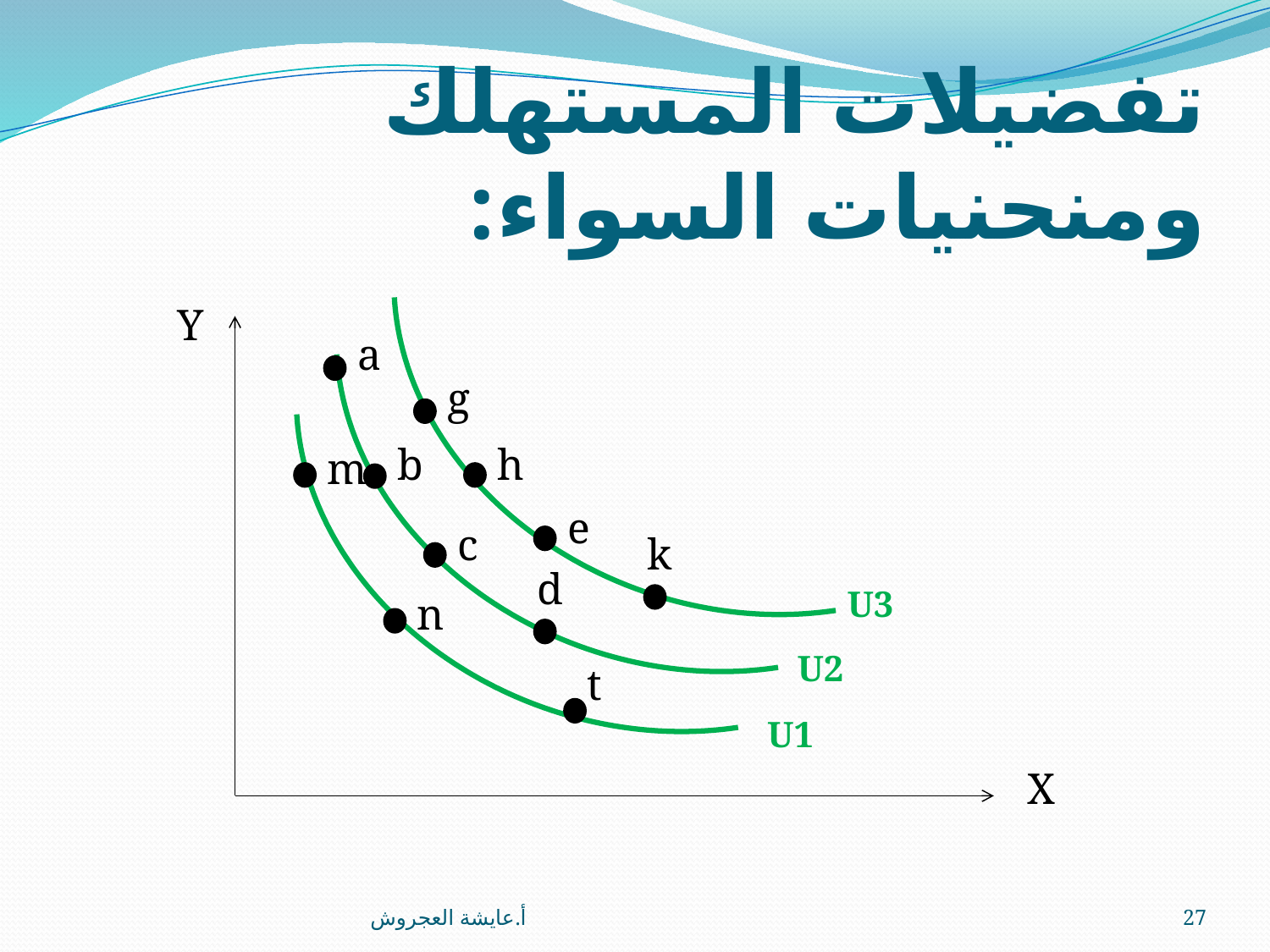
Which labelled point has the highest Y value? a Which labelled point is farthest to the right along the X axis? k Which labelled point has the lowest Y value? t How many indifference curves are drawn on the chart? 3 Which curve is the outermost (farthest from the origin)? U3 Do the curves rise or fall as X increases? Fall What kind of chart is shown on the slide? Line chart (indifference curves) What are the labels of the three curves on the chart? U1, U2, U3 Which labelled point is farthest to the left along the X axis? m What are the labels of the horizontal and vertical axes? X and Y Which point has a higher Y value, point g or point n? g How many labelled points are plotted on the chart? 11